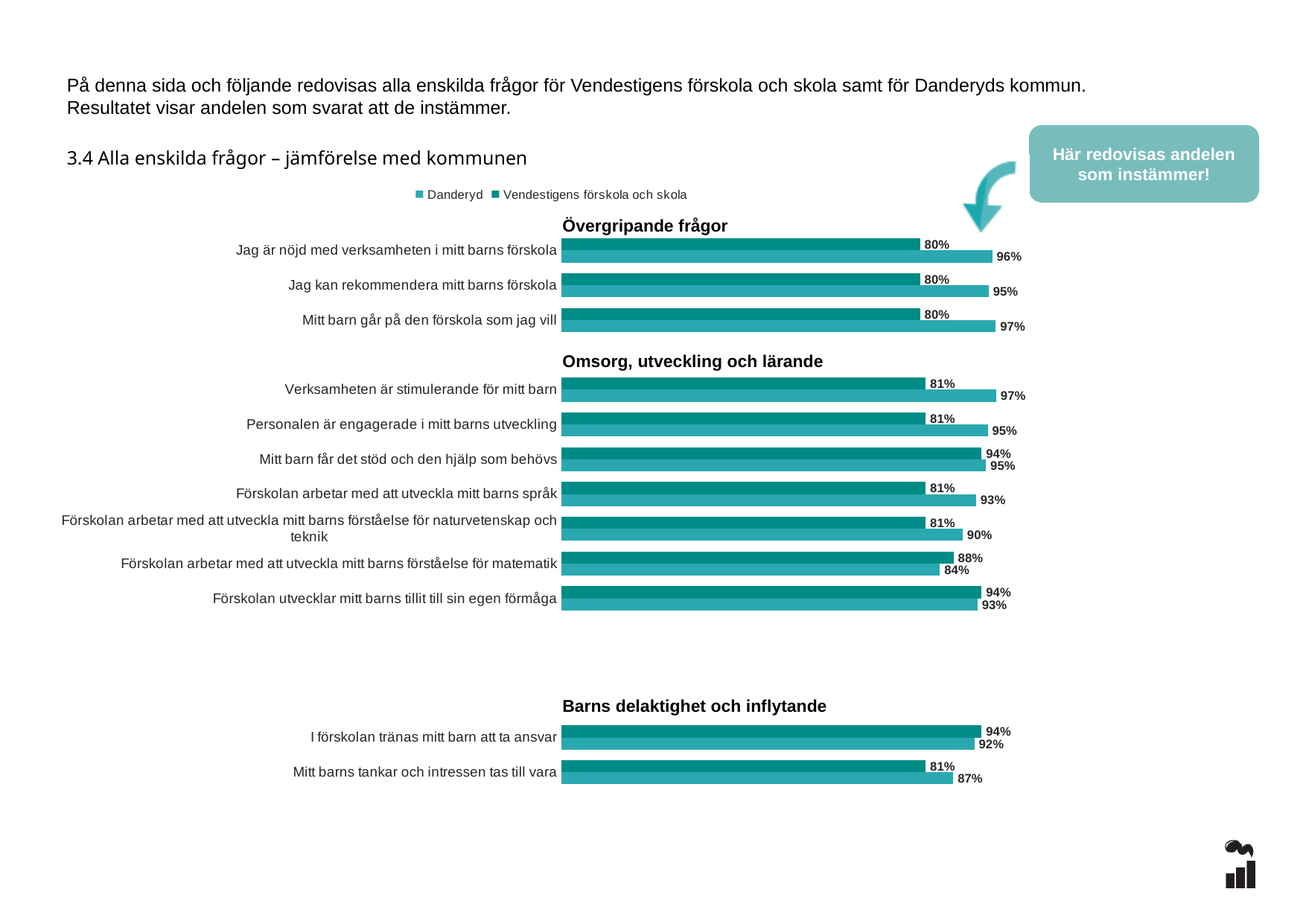
Among the lower (lighter) bars, which category has the lowest value? Förskolan arbetar med att utveckla mitt barns förståelse för matematik (84%) What is the difference between the two bars for "Förskolan arbetar med att utveckla mitt barns förståelse för matematik" (88% and 84%)? 4 percentage points How many question categories are plotted in the chart in total? 12 What are the two series named in the chart legend? Danderyd; Vendestigens förskola och skola What value is shown on the lower (lighter) bar for "Mitt barn går på den förskola som jag vill"? 97% For "Förskolan arbetar med att utveckla mitt barns förståelse för matematik", which bar is larger, the upper (darker) or the lower (lighter) one? The upper (darker) bar, 88% What is the difference between the two bars for "Verksamheten är stimulerande för mitt barn" (97% and 81%)? 16 percentage points How many series does the chart legend list? 2 What type of chart is shown on the slide? Bar chart What value is shown on the upper (darker) bar for "Mitt barn får det stöd och den hjälp som behövs"? 94% What value is shown on the upper (darker) bar for "Jag är nöjd med verksamheten i mitt barns förskola"? 80% What value is shown on the lower (lighter) bar for "Mitt barns tankar och intressen tas till vara"? 87%